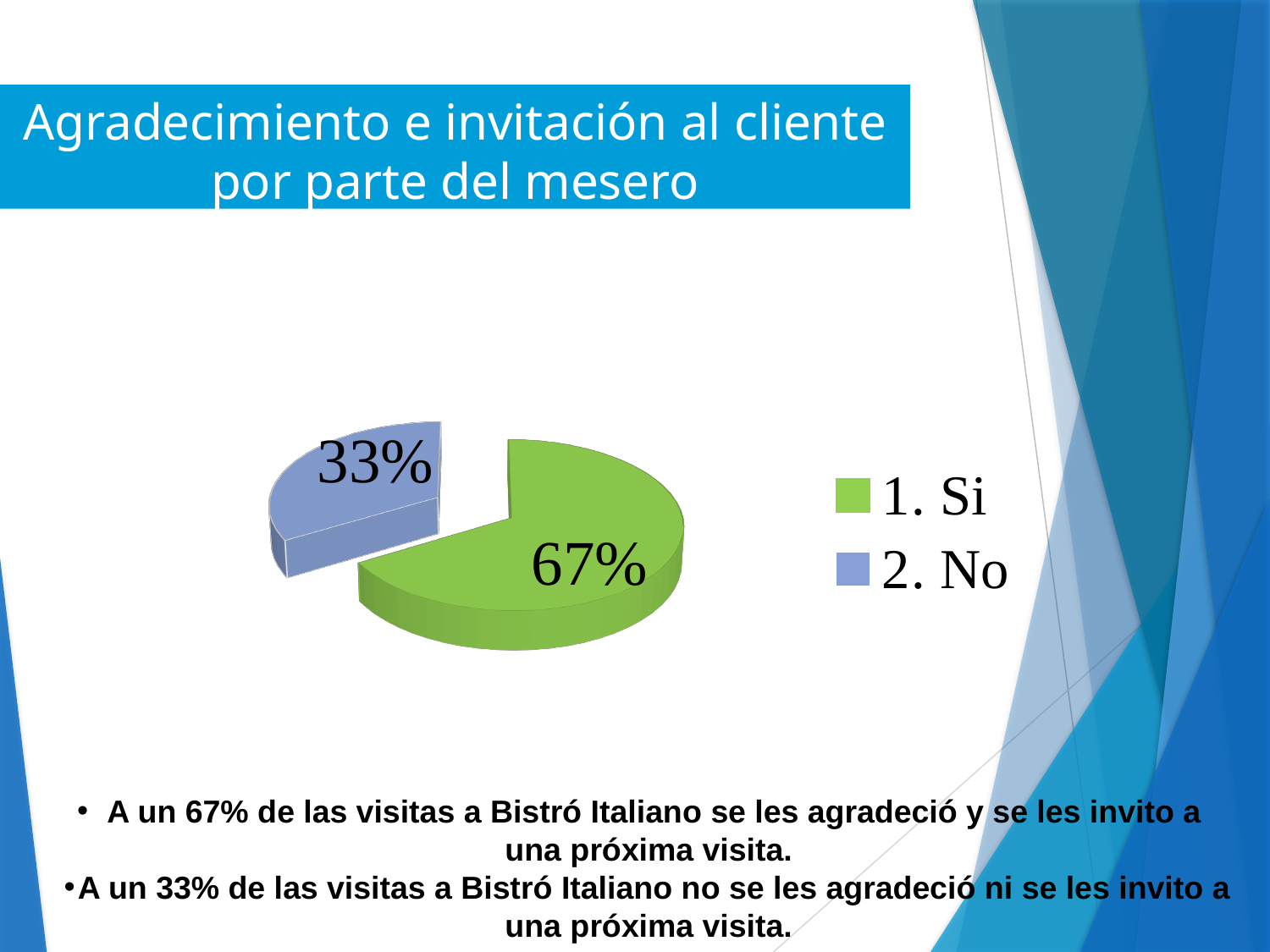
What colour is the "1. Si" slice in the pie chart? green What colour is the "2. No" slice in the pie chart? blue How many slices does the pie chart have? 2 What is the difference in percentage points between the "1. Si" slice and the "2. No" slice? 34 Which category has the largest slice of the pie? 1. Si What kind of chart is shown on the slide? pie chart Which category has the smallest slice of the pie? 2. No How many entries does the legend list? 2 What share of the pie does the "2. No" slice represent? 33% What percentage of the pie is labelled for "1. Si"? 67% Which slice is larger, "1. Si" or "2. No"? 1. Si What percentage of the pie is labelled for "2. No"? 33%